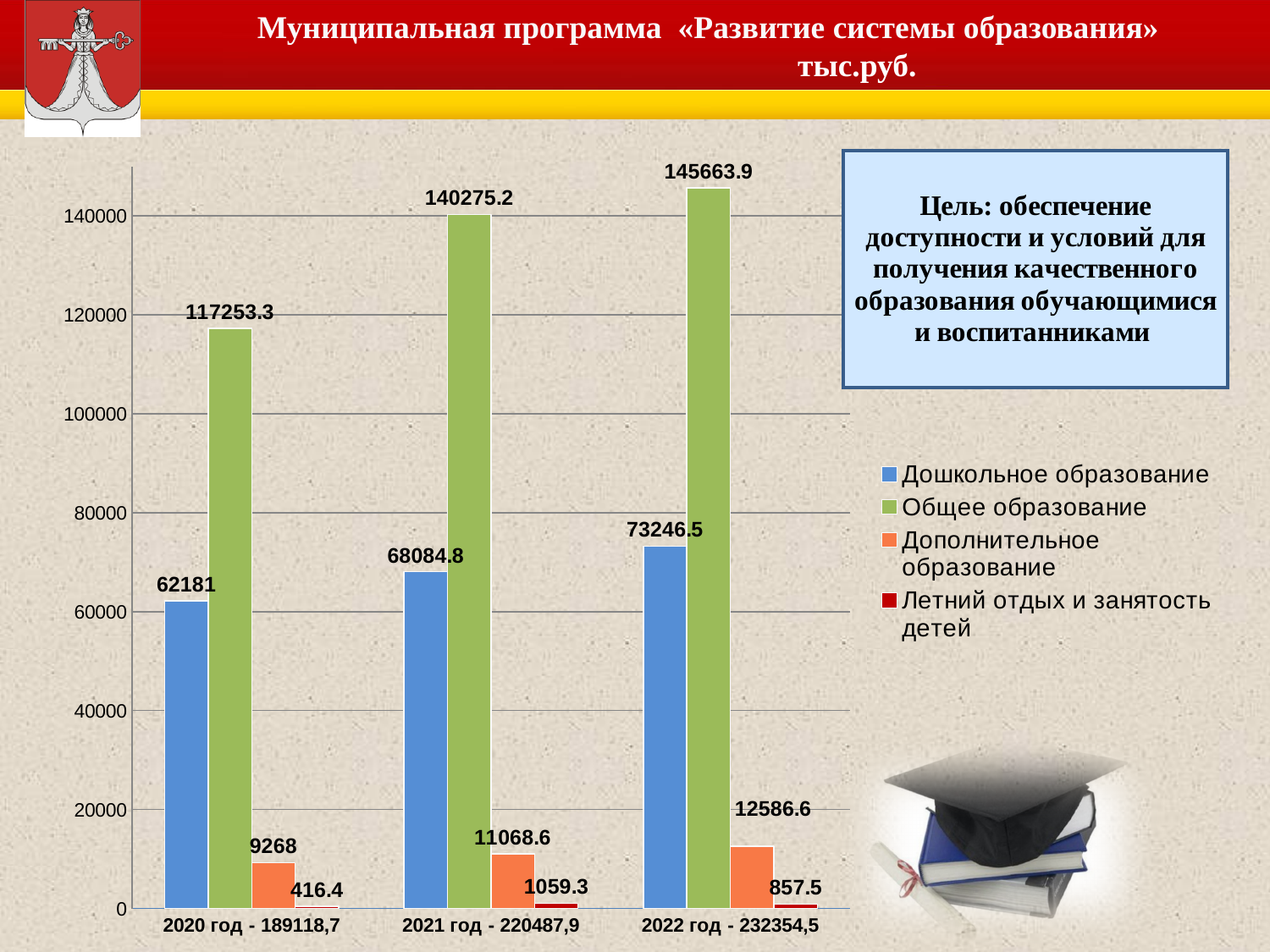
What is the difference between the Общее образование values for 2022 год and 2021 год? 5388.7 Which is larger: Летний отдых и занятость детей in 2021 год or in 2022 год? 2021 год What is the value for Общее образование in 2021 год? 140275.2 What is the difference between the Дошкольное образование values for 2022 год and 2020 год? 11065.5 What kind of chart is shown on the slide? Bar chart Do the values for Дошкольное образование rise or fall from 2020 год to 2022 год? Rise In which year is the value for Общее образование highest? 2022 год In which year is the value for Летний отдых и занятость детей lowest? 2020 год What is the value for Летний отдых и занятость детей in 2022 год? 857.5 What is the value for Дополнительное образование in 2021 год? 11068.6 How many series does the legend list? 4 What is the value for Дошкольное образование in 2020 год? 62181